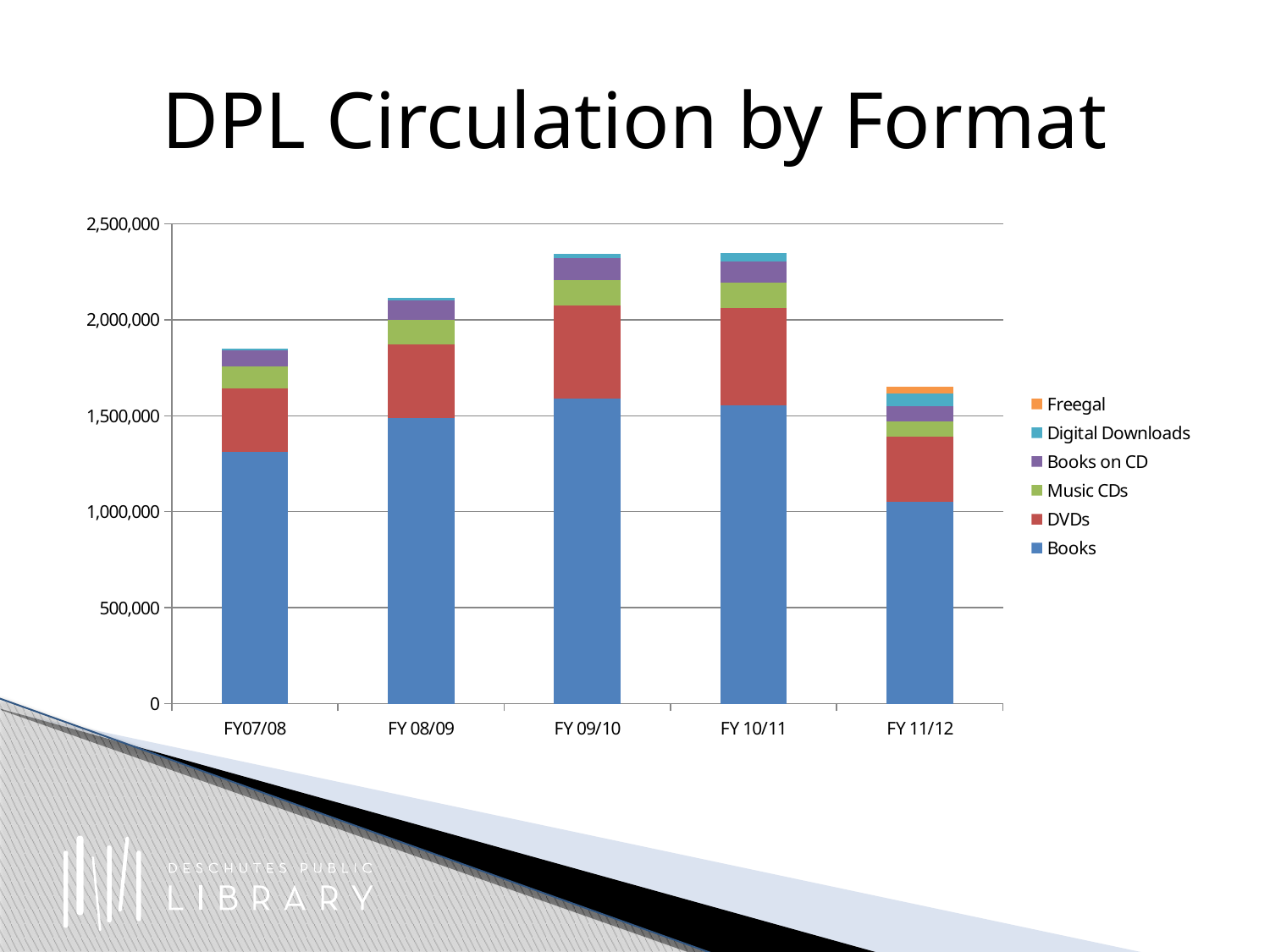
Which fiscal year has the lowest Books circulation? FY 11/12 Which series forms the bottom segment of each stacked bar? Books Which fiscal year has the lowest total circulation? FY 11/12 How many fiscal years are shown on the x axis? 5 How many series does the legend list? 6 What kind of chart is shown on the slide? stacked bar chart Is the Books value for FY 11/12 greater or less than 1,500,000? less Which has the larger total circulation, FY07/08 or FY 08/09? FY 08/09 Is the Books value for FY07/08 greater or less than 1,500,000? less Which series appears only in the FY 11/12 bar? Freegal Is the total circulation for FY 09/10 greater or less than 2,000,000? greater